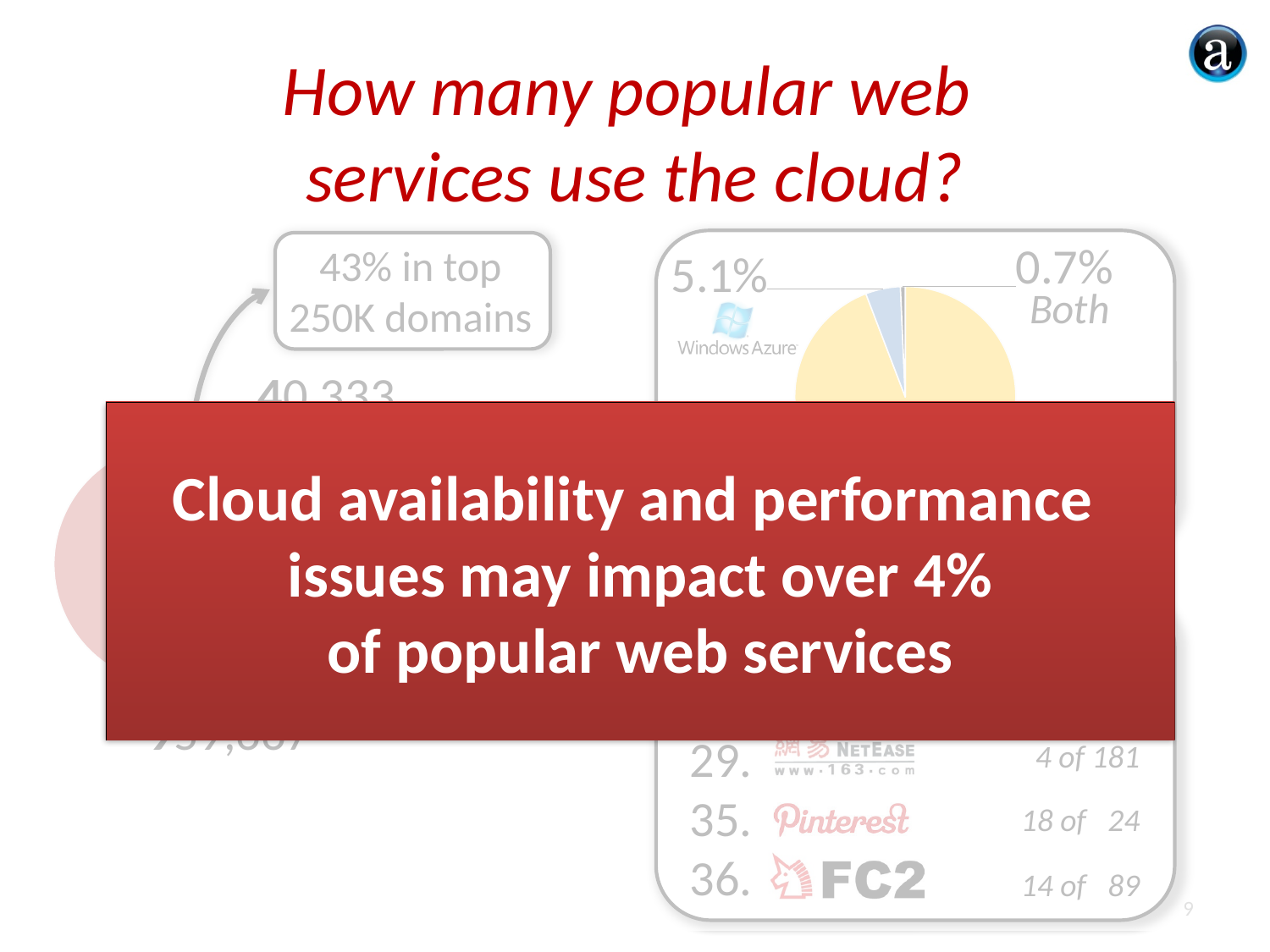
In the pie chart on the right, which labelled slice is larger: Windows Azure or Both? Windows Azure In the pie chart on the right, what is the difference between the Windows Azure share (5.1%) and the 'Both' share (0.7%)? 4.4% What percentage is stated in the callout box above the chart on the left side of the slide? 43% What kind of chart is shown on the right side of the slide, behind the red banner? pie chart In the pie chart on the right, what percentage is labelled for the slice marked 'Both'? 0.7% Which cloud provider's logo appears next to the 5.1% label in the pie chart on the right? Windows Azure In the pie chart on the right, what percentage is labelled for the Windows Azure slice? 5.1% In the pie chart on the right, is the Windows Azure share greater or less than 5%? greater In the pie chart on the right, is the share labelled 'Both' greater or less than 1%? less